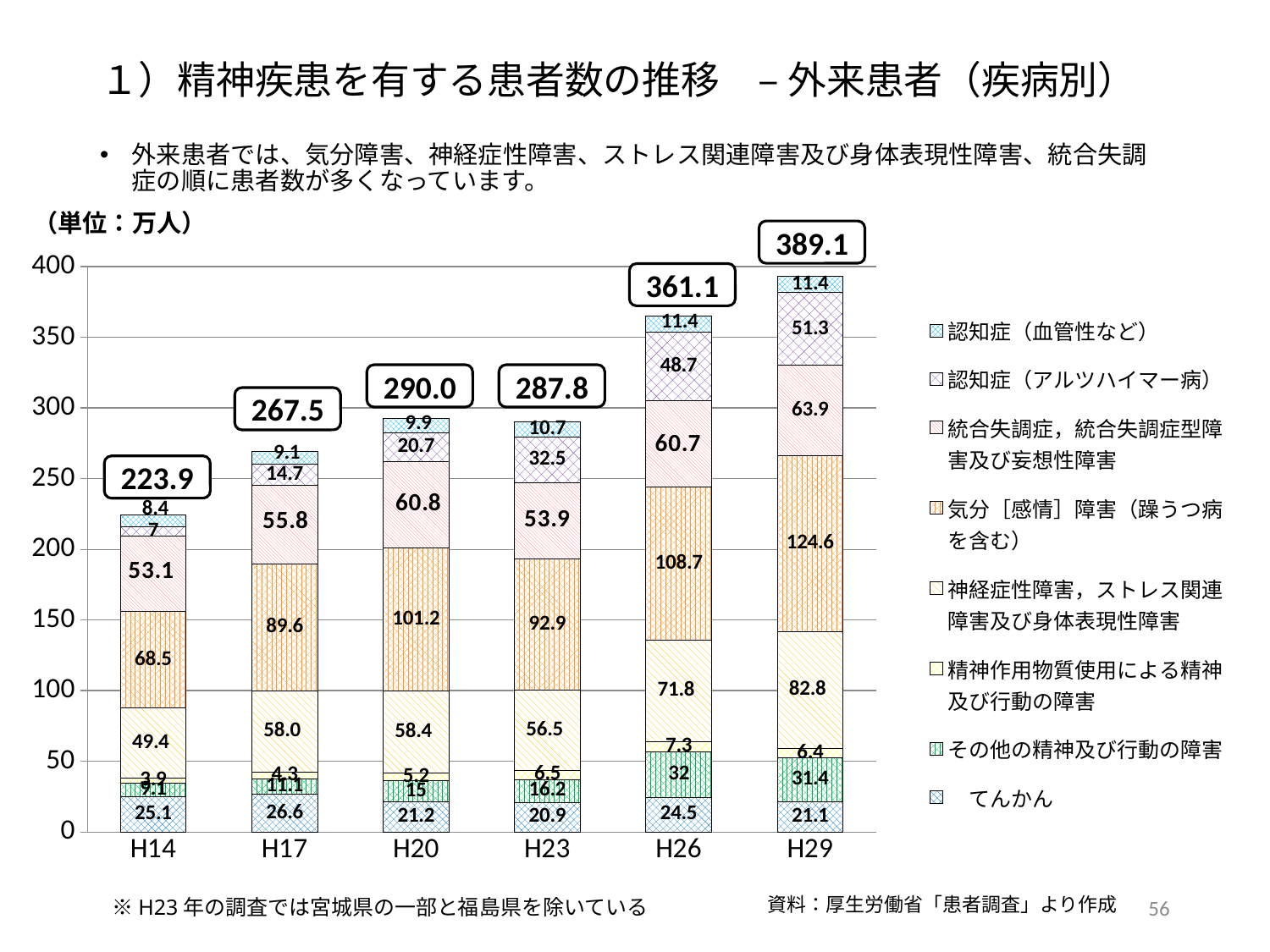
What unit is stated for the values in the chart? 万人 What is the value of the 気分［感情］障害（躁うつ病を含む） segment for H29? 124.6 Is the total for H17 greater or less than 250? greater How many years (categories) are shown on the x axis? 6 What is the value of the 神経症性障害，ストレス関連障害及び身体表現性障害 segment for H14? 49.4 Which total is larger, H20 or H23? H20 What is the total number of outpatients shown for H29? 389.1 What kind of chart is shown on the slide? Stacked bar chart What is the difference between the total for H29 and the total for H26? 28.0 How many series does the legend list? 8 Which year has the lowest total number of outpatients? H14 Which year has the highest total number of outpatients? H29